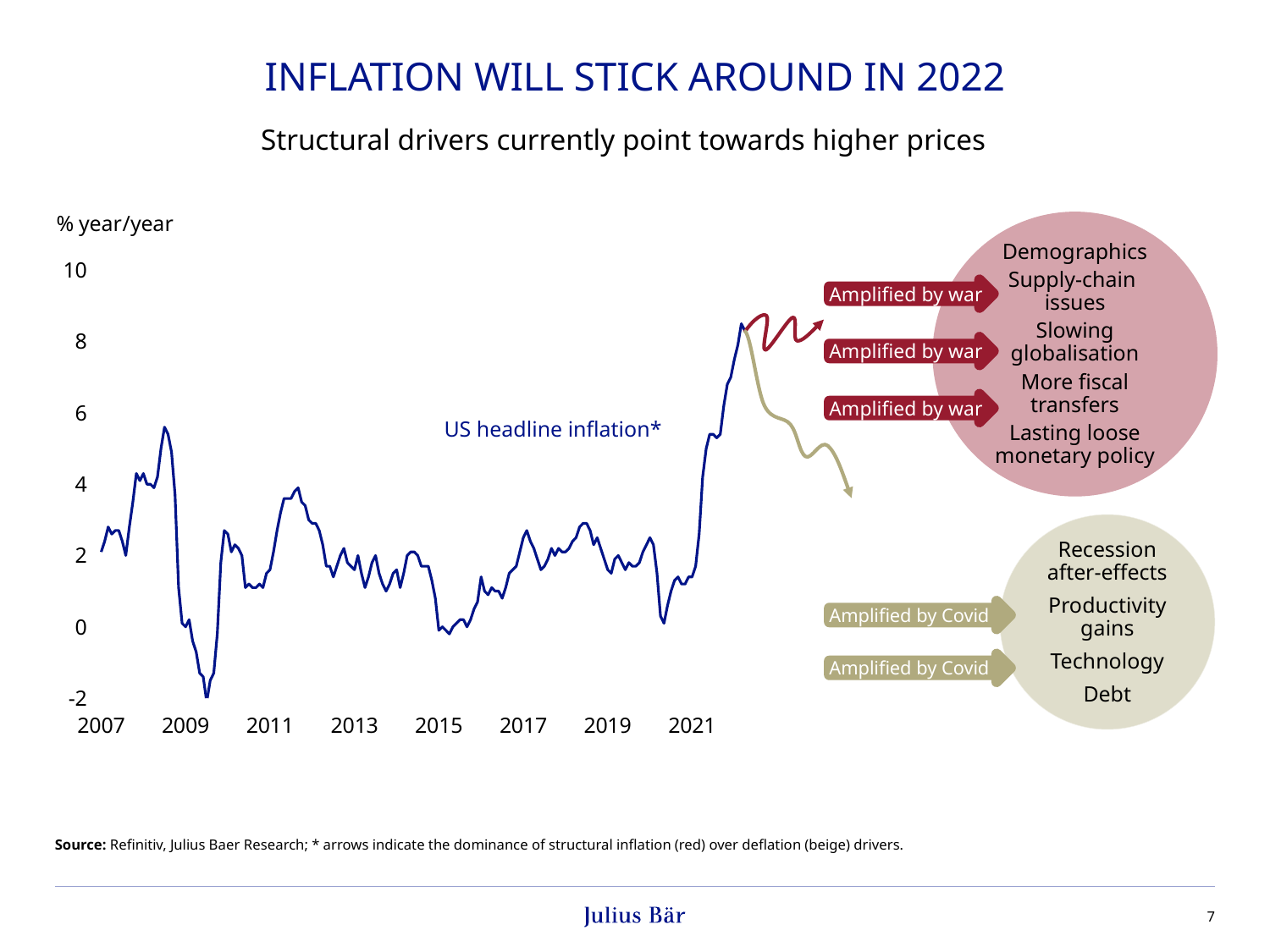
Is the peak value of the line reached after 2021 greater or less than 8? greater Does the line rise or fall between its 2008 peak and 2009? fall What series does the line in the chart represent? US headline inflation* Is the lowest value of the line, reached around 2009, greater or less than 0? less What kind of chart is shown on the slide? line chart Around which labelled year does the line reach its lowest value? 2009 Does the line rise or fall between 2020 and the end of 2021? rise Does the line reach its highest value near the start or near the end of the period shown? near the end Is the peak value of the line reached in 2008 greater or less than 4? greater In what unit are the values on the vertical axis expressed? % year/year How many year labels are shown on the horizontal axis? 8 Which is higher: the peak of the line in 2008 or the peak after 2021? the peak after 2021